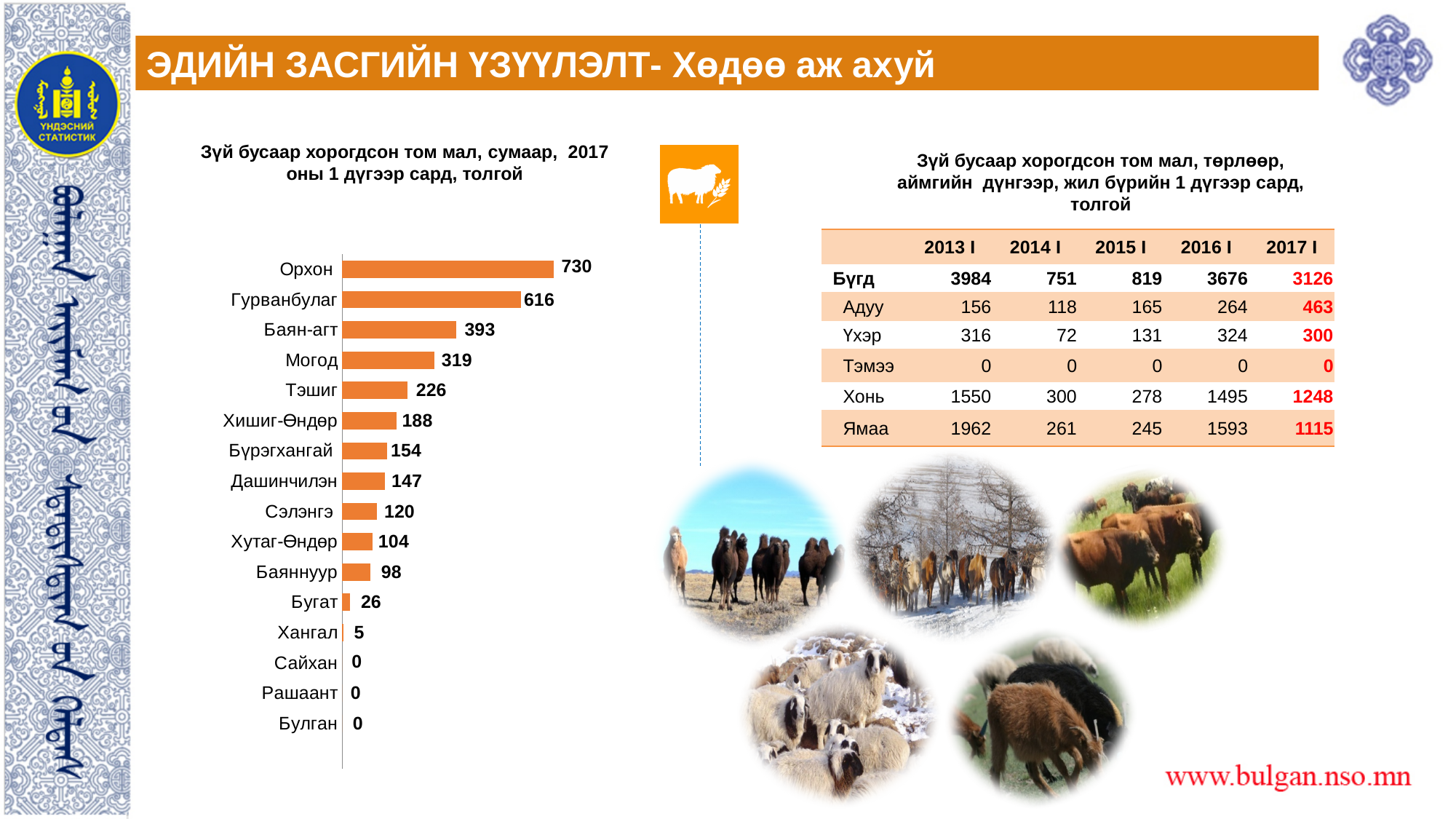
What is the value for Бугат in the bar chart? 26 What kind of chart is shown on the left of the slide? Bar chart What is the difference between the values for Баян-агт and Тэшиг in the bar chart? 167 How many categories are shown in the bar chart? 16 Which category has the highest value in the bar chart? Орхон What is the value for Орхон in the bar chart? 730 What is the difference between the values for Орхон and Гурванбулаг in the bar chart? 114 Which category has the lowest non-zero value in the bar chart? Хангал How many categories in the bar chart have a value of 0? 3 What is the value for Могод in the bar chart? 319 Which is larger in the bar chart, Бүрэгхангай or Дашинчилэн? Бүрэгхангай What is the value for Хутаг-Өндөр in the bar chart? 104